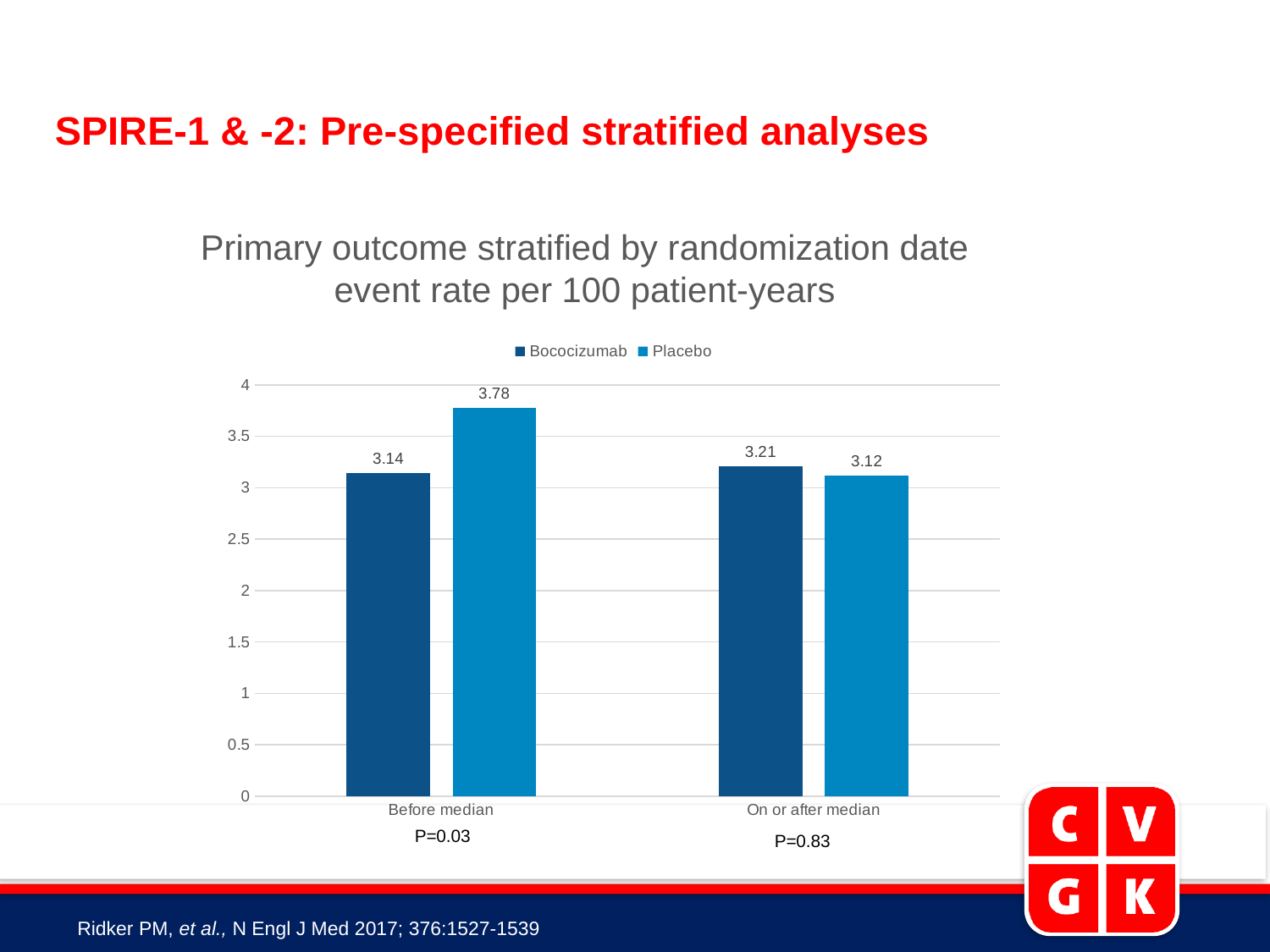
Which bar shows the highest event rate on the chart? Placebo, Before median What P value is shown under the Before median group? P=0.03 What is the event rate for Placebo in the On or after median group? 3.12 Which bar shows the lowest event rate on the chart? Placebo, On or after median What is the event rate for Bococizumab in the Before median group? 3.14 In the Before median group, which is larger, the Bococizumab or the Placebo event rate? Placebo What is the difference between the Placebo and Bococizumab event rates in the Before median group? 0.64 What is the event rate for Bococizumab in the On or after median group? 3.21 What is the event rate for Placebo in the Before median group? 3.78 How many series does the legend list? 2 What kind of chart is shown on the slide? Bar chart How many categories are shown on the x axis? 2